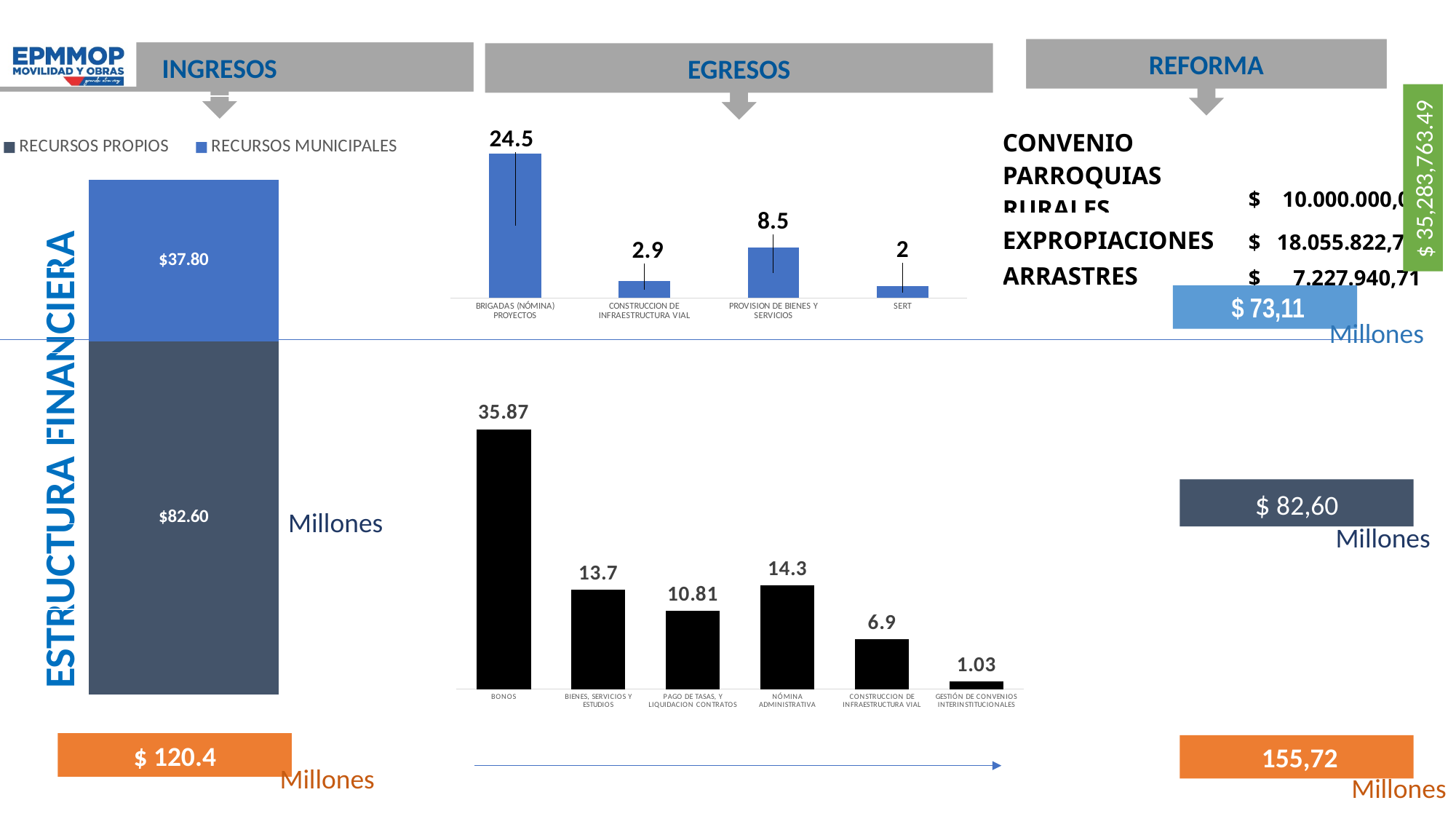
In the black bar chart at the bottom middle of the slide, what is the value for PAGO DE TASAS, Y LIQUIDACION CONTRATOS? 10.81 In the blue bar chart at the top middle of the slide, what is the value for BRIGADAS (NÓMINA) PROYECTOS? 24.5 In the black bar chart at the bottom middle of the slide, which category has the highest value? BONOS In the blue bar chart at the top middle of the slide, what is the difference between PROVISION DE BIENES Y SERVICIOS and CONSTRUCCION DE INFRAESTRUCTURA VIAL? 5.6 In the stacked bar chart on the left under INGRESOS, what is the value for RECURSOS PROPIOS? $82.60 In the black bar chart at the bottom middle of the slide, which is larger: NÓMINA ADMINISTRATIVA or BIENES, SERVICIOS Y ESTUDIOS? NÓMINA ADMINISTRATIVA In the stacked bar chart on the left under INGRESOS, what is the value for RECURSOS MUNICIPALES? $37.80 In the blue bar chart at the top middle of the slide, how many categories are shown? 4 In the black bar chart at the bottom middle of the slide, how many categories are shown? 6 In the blue bar chart at the top middle of the slide, which category has the lowest value? SERT What kind of chart is the black chart at the bottom middle of the slide? Bar chart How many series does the legend of the stacked bar chart on the left list? 2